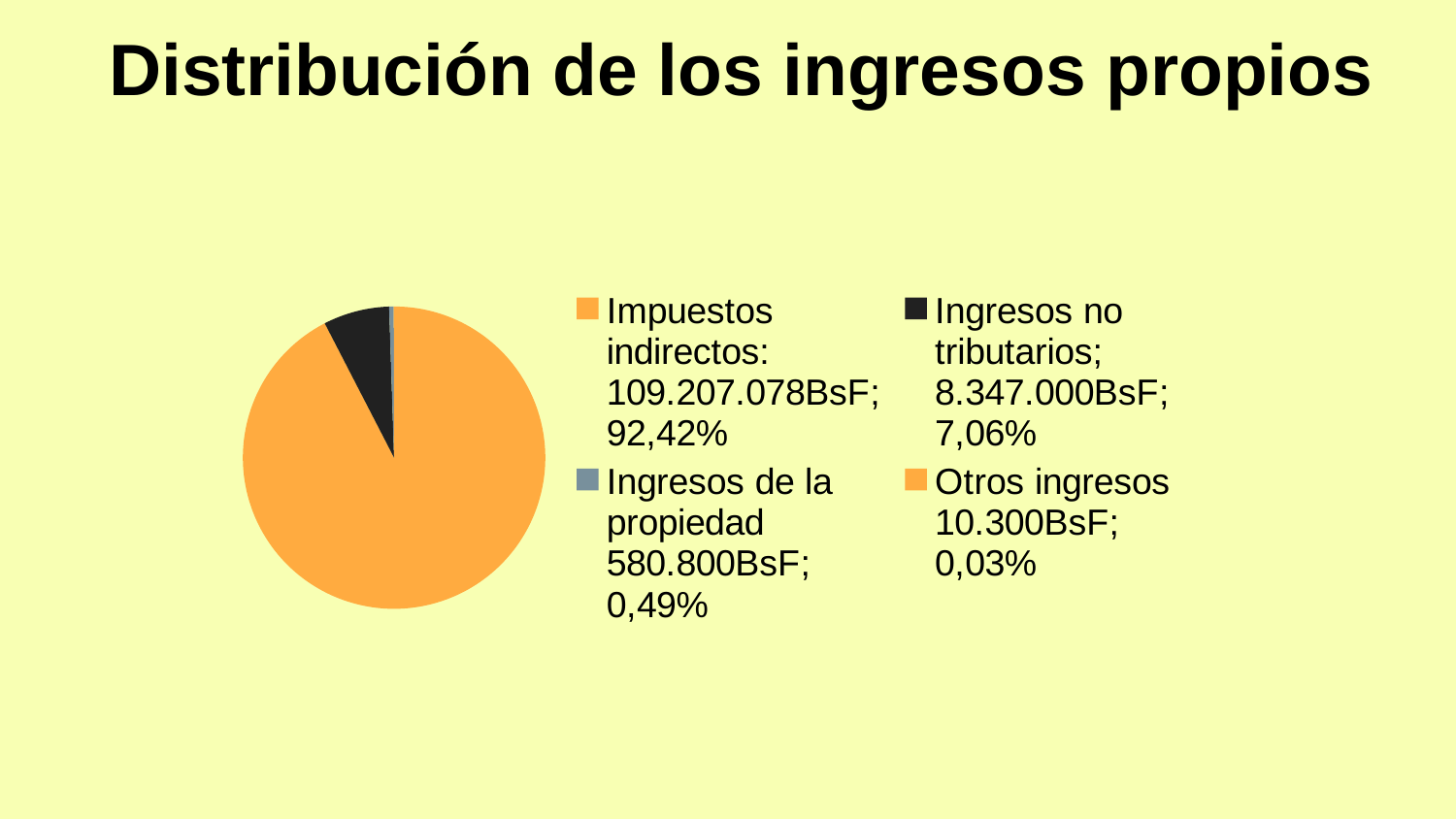
What share of the pie does Impuestos indirectos represent? 92,42% Which is larger, Ingresos no tributarios or Ingresos de la propiedad? Ingresos no tributarios What is the difference in percentage points between Impuestos indirectos and Ingresos no tributarios? 85,36% Which category has the smallest slice of the pie? Otros ingresos What is the title of the chart on the slide? Distribución de los ingresos propios What colour is the slice for Ingresos no tributarios? Black What kind of chart is shown on the slide? Pie chart What is the value shown for Ingresos de la propiedad? 580.800BsF What percentage is shown for Otros ingresos? 0,03% What is the value shown for Ingresos no tributarios? 8.347.000BsF Which category has the largest slice of the pie? Impuestos indirectos How many categories does the pie chart have? 4